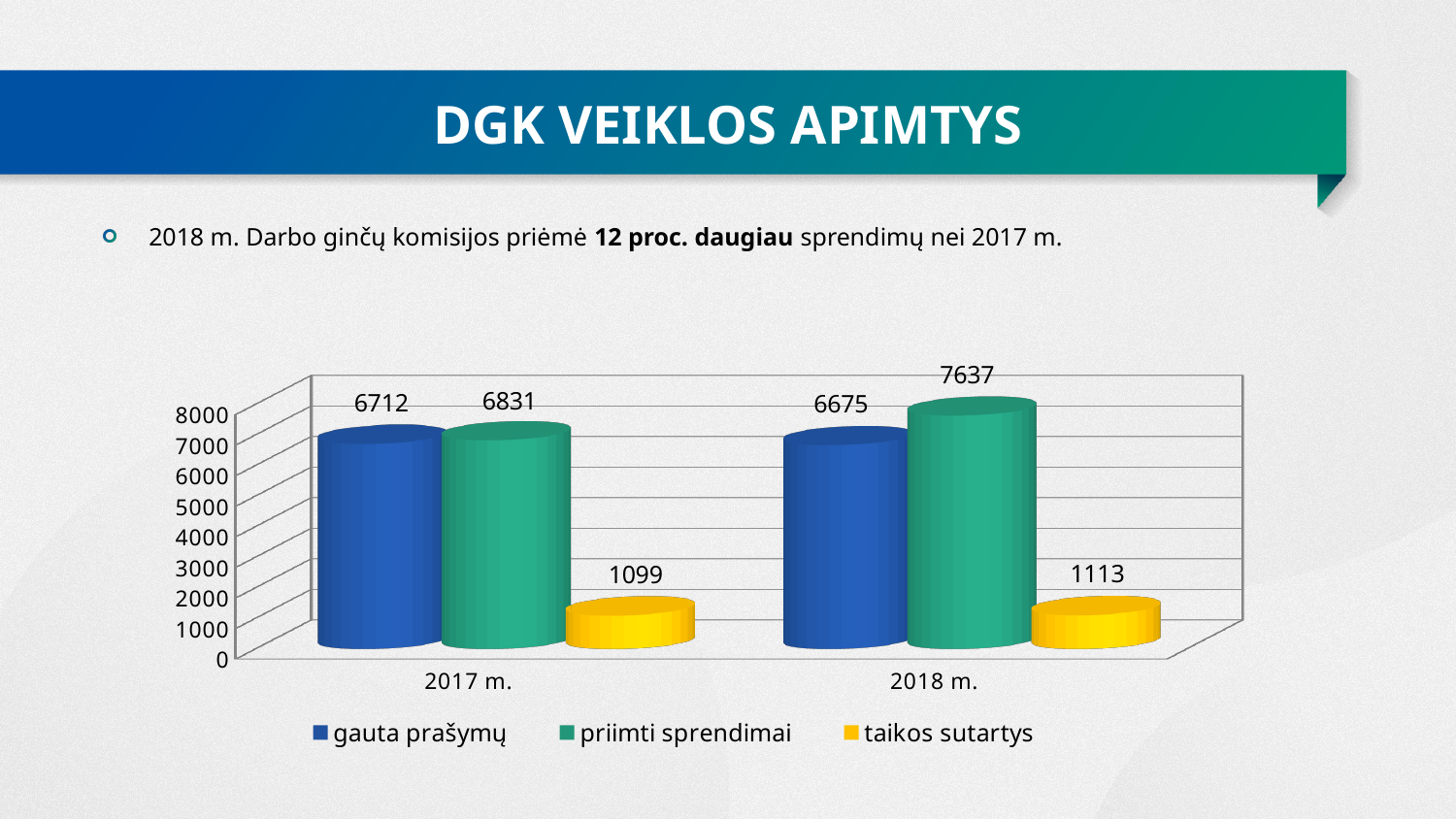
How many series does the legend list? 3 What kind of chart is shown on the slide? bar chart What is the value of 'taikos sutartys' for 2017 m.? 1099 What is the difference between 'priimti sprendimai' in 2018 m. and in 2017 m.? 806 Which series has the lowest value in 2017 m.? taikos sutartys How many categories are shown on the x axis? 2 What is the value of 'gauta prašymų' for 2018 m.? 6675 What colour represents 'taikos sutartys' in the chart? yellow Which is larger: 'gauta prašymų' in 2017 m. or in 2018 m.? 2017 m. What is the value of 'priimti sprendimai' for 2018 m.? 7637 Which series has the highest value in 2018 m.? priimti sprendimai What is the value of 'gauta prašymų' for 2017 m.? 6712